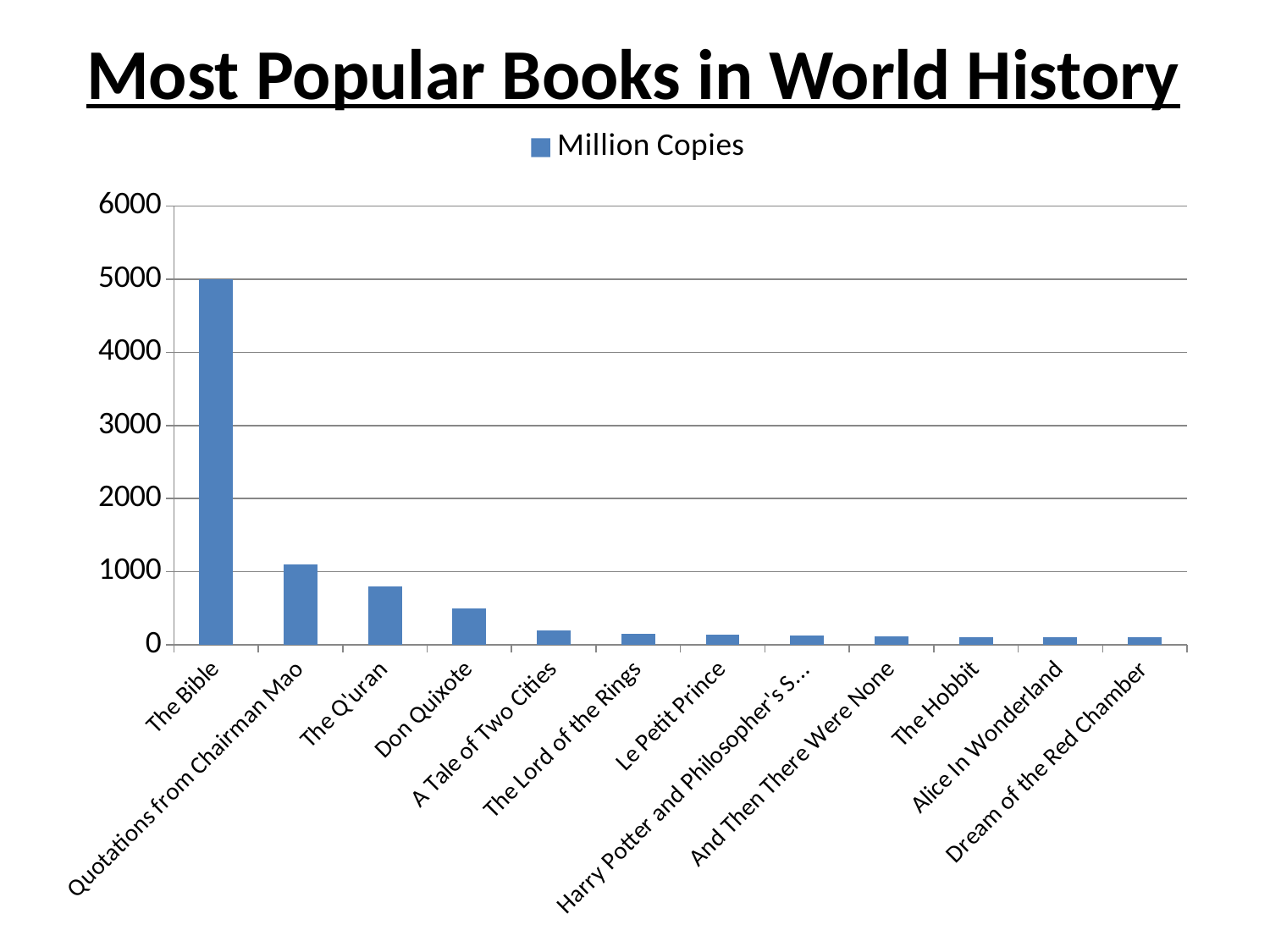
Which book has the highest value on the chart? The Bible Is the value for The Q'uran greater or less than 1000? less How many books (categories) are plotted on the chart? 12 How many series does the legend list? 1 Is the value for Quotations from Chairman Mao greater or less than 1000? greater What is the value for The Bible in million copies? 5000 Which is larger, the value for The Q'uran or the value for Don Quixote? The Q'uran What kind of chart is shown on the slide? bar chart Do the values rise or fall moving from left to right along the x axis? fall What is the name of the series shown in the legend? Million Copies Is the value for Don Quixote greater or less than 1000? less What is the title of the slide? Most Popular Books in World History